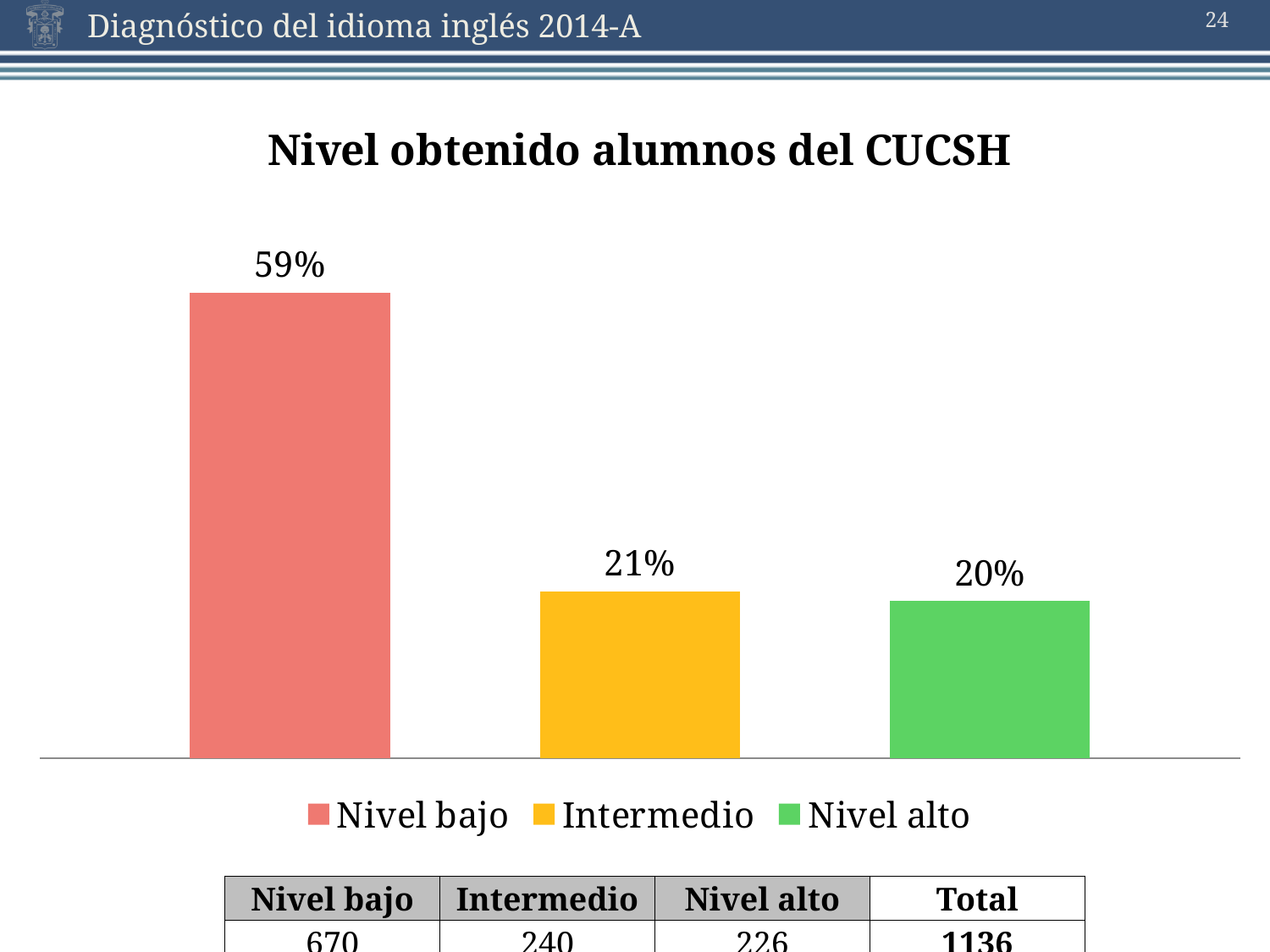
Which level has the highest percentage? Nivel bajo What kind of chart is shown on the slide? bar chart Which is larger, the value for Nivel bajo or the value for Nivel alto? Nivel bajo What percentage is shown for Nivel bajo? 59% What is the difference in percentage points between Intermedio and Nivel alto? 1 What is the title of the chart? Nivel obtenido alumnos del CUCSH What is the difference in percentage points between Nivel bajo and Intermedio? 38 How many bars are plotted in the chart? 3 How many entries does the legend list? 3 What percentage is shown for Intermedio? 21% Which level has the lowest percentage? Nivel alto What percentage is shown for Nivel alto? 20%